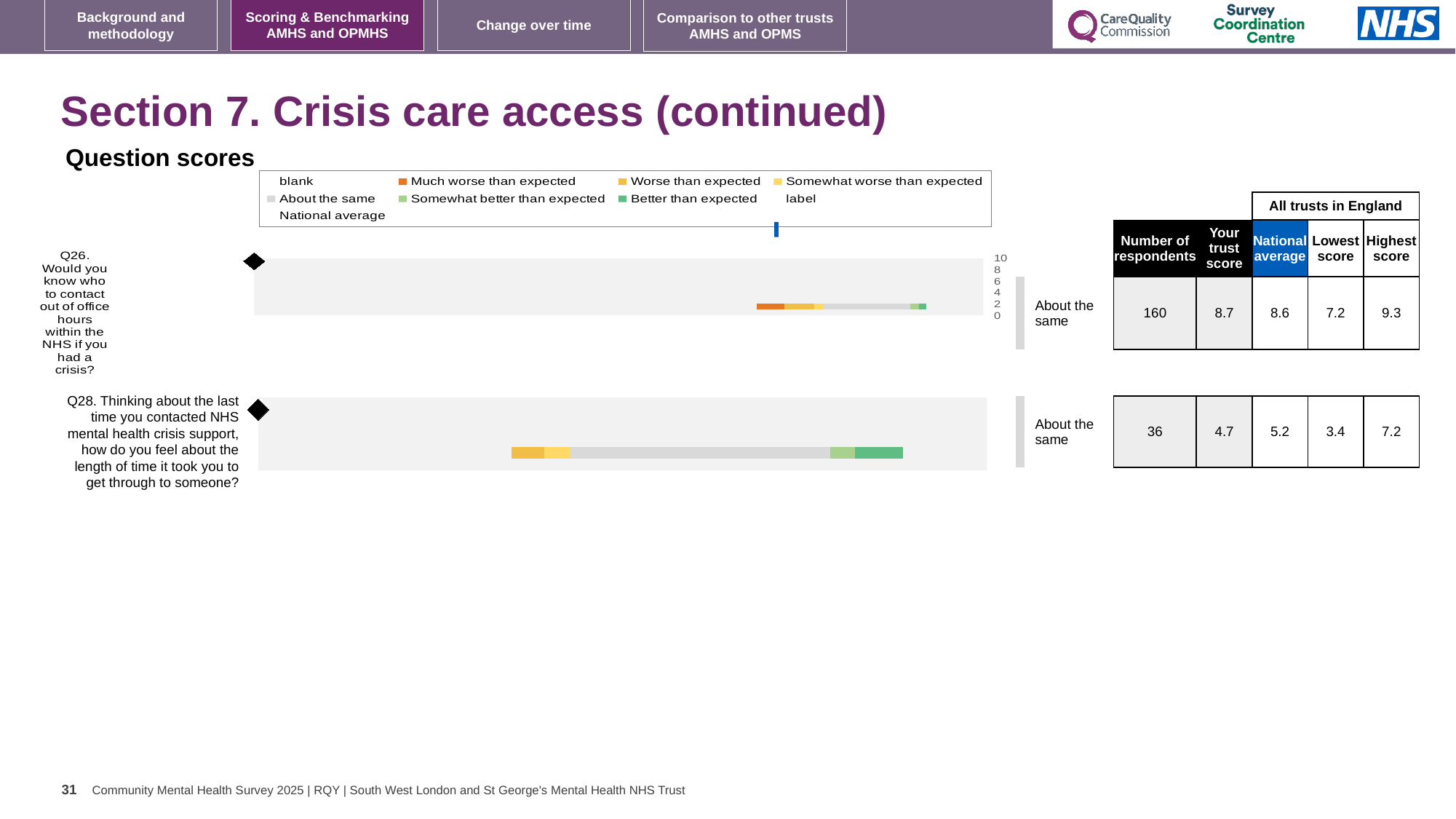
How many questions are plotted in the question scores charts on this slide? 2 What benchmark category is shown next to the Q26 chart? About the same For Q28, what is the national average score? 5.2 For Q28, which is larger: your trust score or the national average? National average For Q26, what is the difference between the highest score and the lowest score across all trusts in England? 2.1 For Q26 (Would you know who to contact out of office hours within the NHS if you had a crisis?), what is the number of respondents? 160 What kind of chart is used to show the question scores on this slide? bar chart For Q28 (length of time it took to get through to someone), what is your trust score? 4.7 For Q26, what is your trust score? 8.7 Which question has the higher trust score, Q26 or Q28? Q26 For Q28, what is the number of respondents? 36 For Q26, which is larger: your trust score or the national average? Your trust score